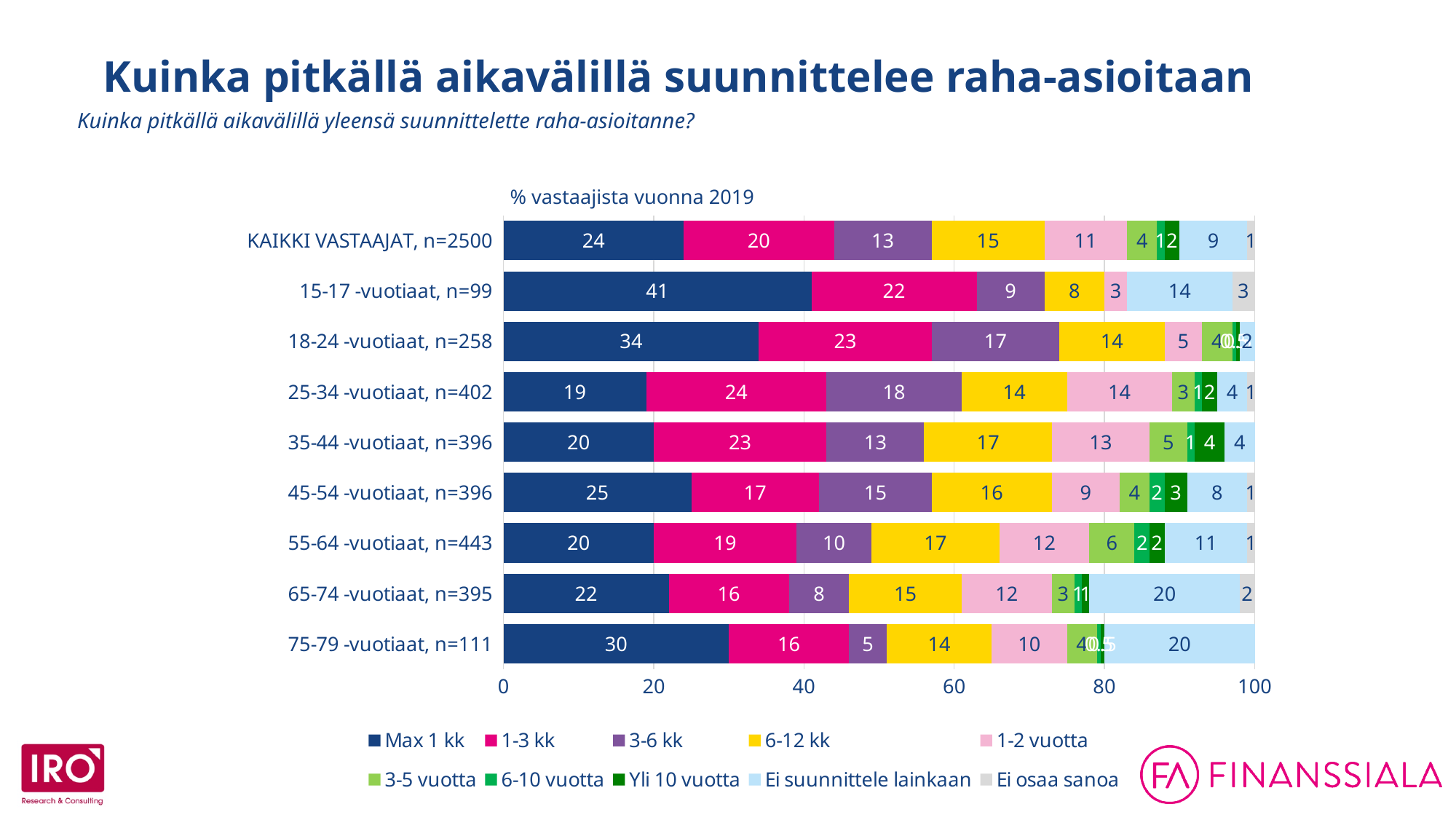
What is the value for "3-6 kk" in the "25-34 -vuotiaat, n=402" bar? 18 What is the difference between the "1-3 kk" values for "25-34 -vuotiaat, n=402" and "45-54 -vuotiaat, n=396"? 7 Which category has the lowest value for "3-6 kk"? 75-79 -vuotiaat, n=111 What kind of chart is shown on the slide? Stacked bar chart Which has the larger "6-12 kk" value: "35-44 -vuotiaat, n=396" or "65-74 -vuotiaat, n=395"? 35-44 -vuotiaat, n=396 What is the value for "Ei suunnittele lainkaan" in the "65-74 -vuotiaat, n=395" bar? 20 How many series does the legend list? 10 What text appears directly above the chart as its subtitle? % vastaajista vuonna 2019 Which category has the highest value for "Max 1 kk"? 15-17 -vuotiaat, n=99 What is the value for "1-2 vuotta" in the "KAIKKI VASTAAJAT, n=2500" bar? 11 How many categories (bars) are shown in the chart? 9 What is the value for "Max 1 kk" in the "15-17 -vuotiaat, n=99" bar? 41